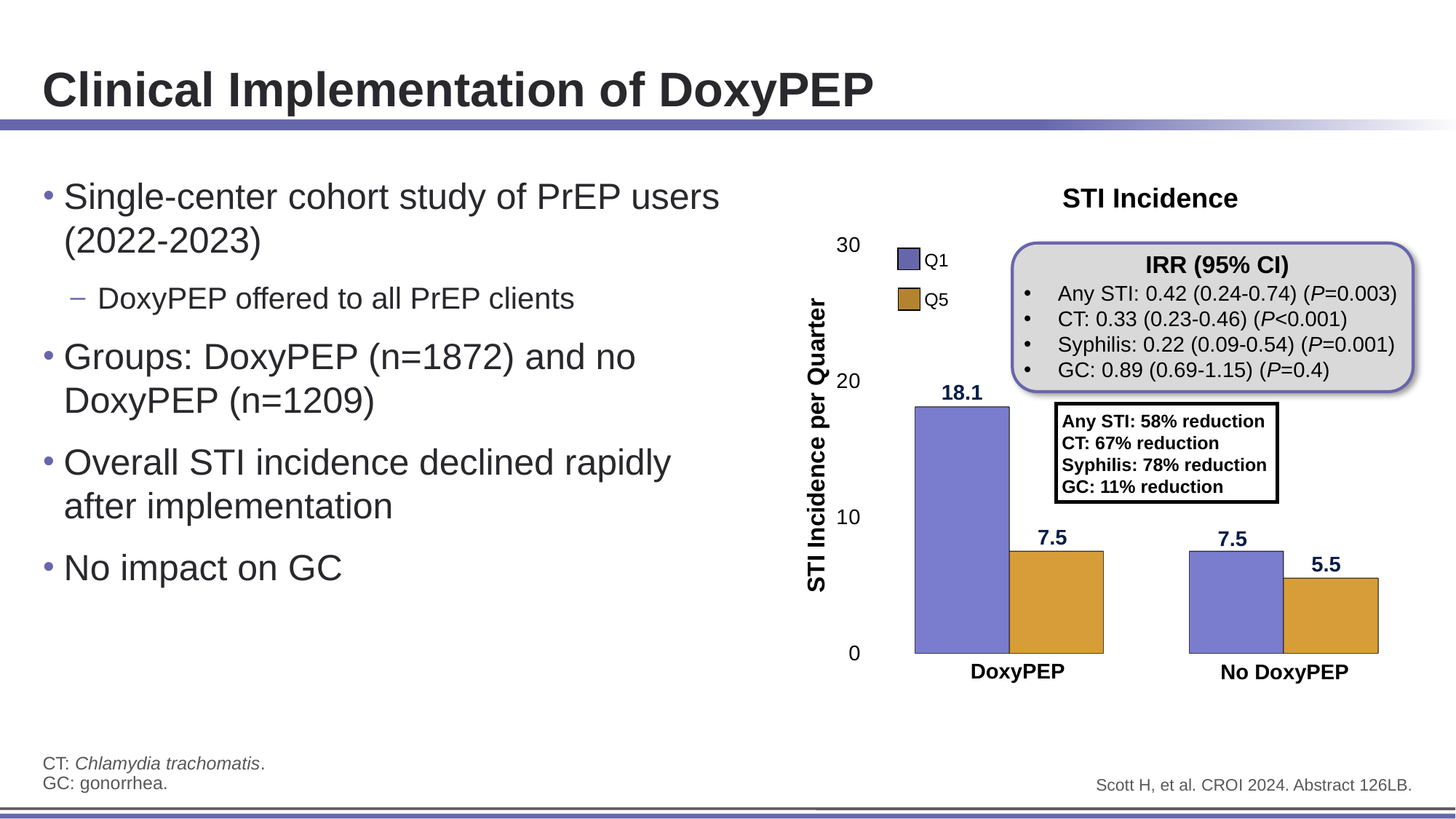
What is the title of the chart? STI Incidence What is the Q5 STI incidence per quarter for the No DoxyPEP group? 5.5 How many series does the legend list? 2 What is the Q1 STI incidence per quarter for the No DoxyPEP group? 7.5 Is the Q1 STI incidence for DoxyPEP greater or less than 20? less Which bar shows the lowest STI incidence on the chart? No DoxyPEP Q5 What kind of chart is shown on the slide? Bar chart What is the difference between the Q1 and Q5 STI incidence for the No DoxyPEP group? 2.0 Which group has the highest Q1 STI incidence? DoxyPEP What is the difference between the Q1 and Q5 STI incidence for the DoxyPEP group? 10.6 What is the Q5 STI incidence per quarter for the DoxyPEP group? 7.5 What is the Q1 STI incidence per quarter for the DoxyPEP group? 18.1